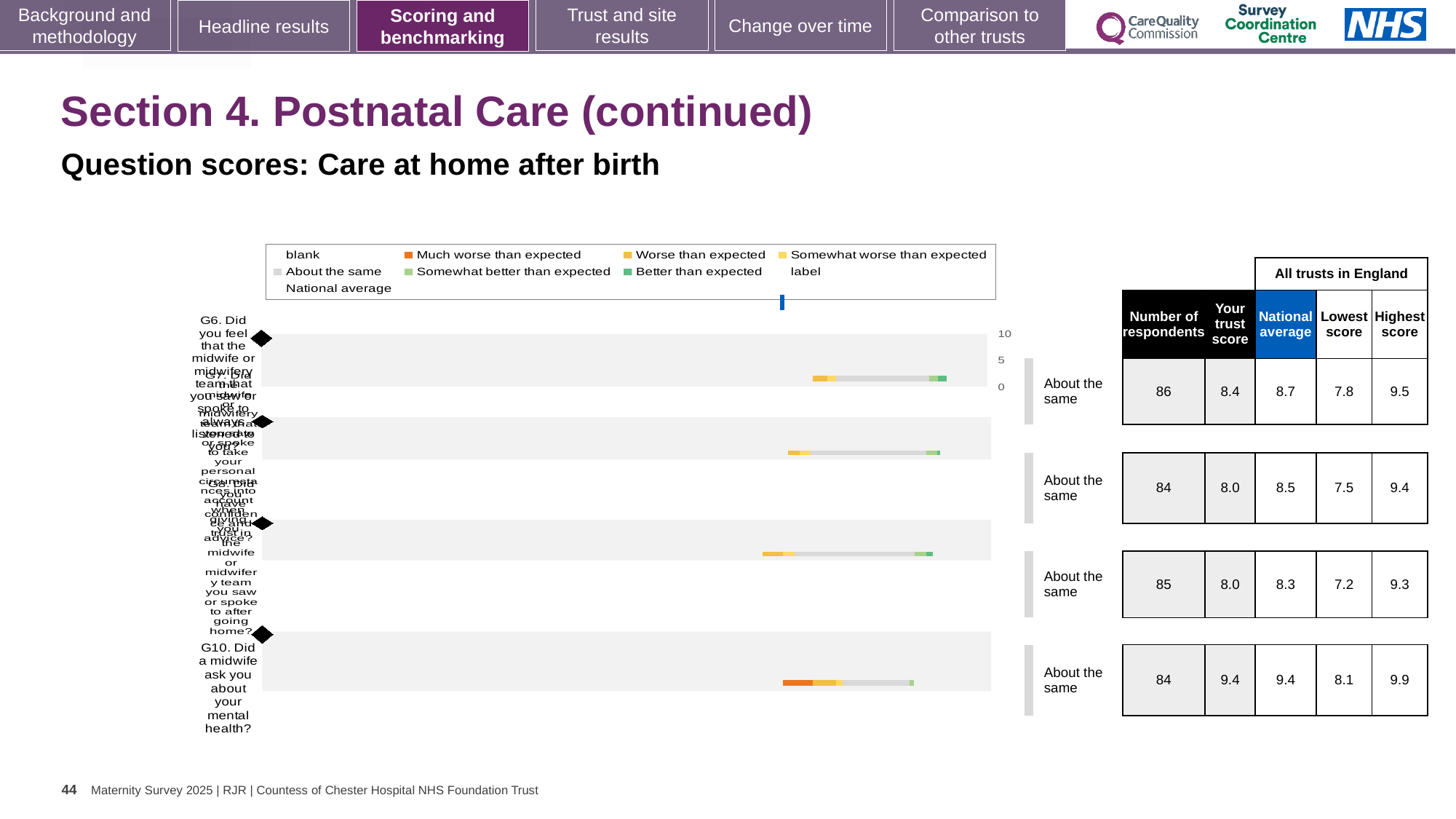
In the table, what is the national average for G6 (Did you feel that the midwife or midwifery team listened to you?)? 8.7 In the table, what is the highest score across all trusts in England for G10? 9.9 In the table, what is the trust score for G10 (Did a midwife ask you about your mental health?)? 9.4 What kind of chart is used to show the question scores on this slide? bar chart How many question rows (bars) are plotted in the chart? 4 What benchmark category is shown for every question row on this slide? About the same In the table, what is the lowest score across all trusts in England for G6? 7.8 For G6, what is the difference between the national average and the trust score? 0.3 Which question row has the highest trust score in the table? G10 Which question row has the highest number of respondents in the table? G6 In the table next to the chart, what is the number of respondents for G10 (Did a midwife ask you about your mental health?)? 84 For G6, which is larger: the trust score or the national average? National average